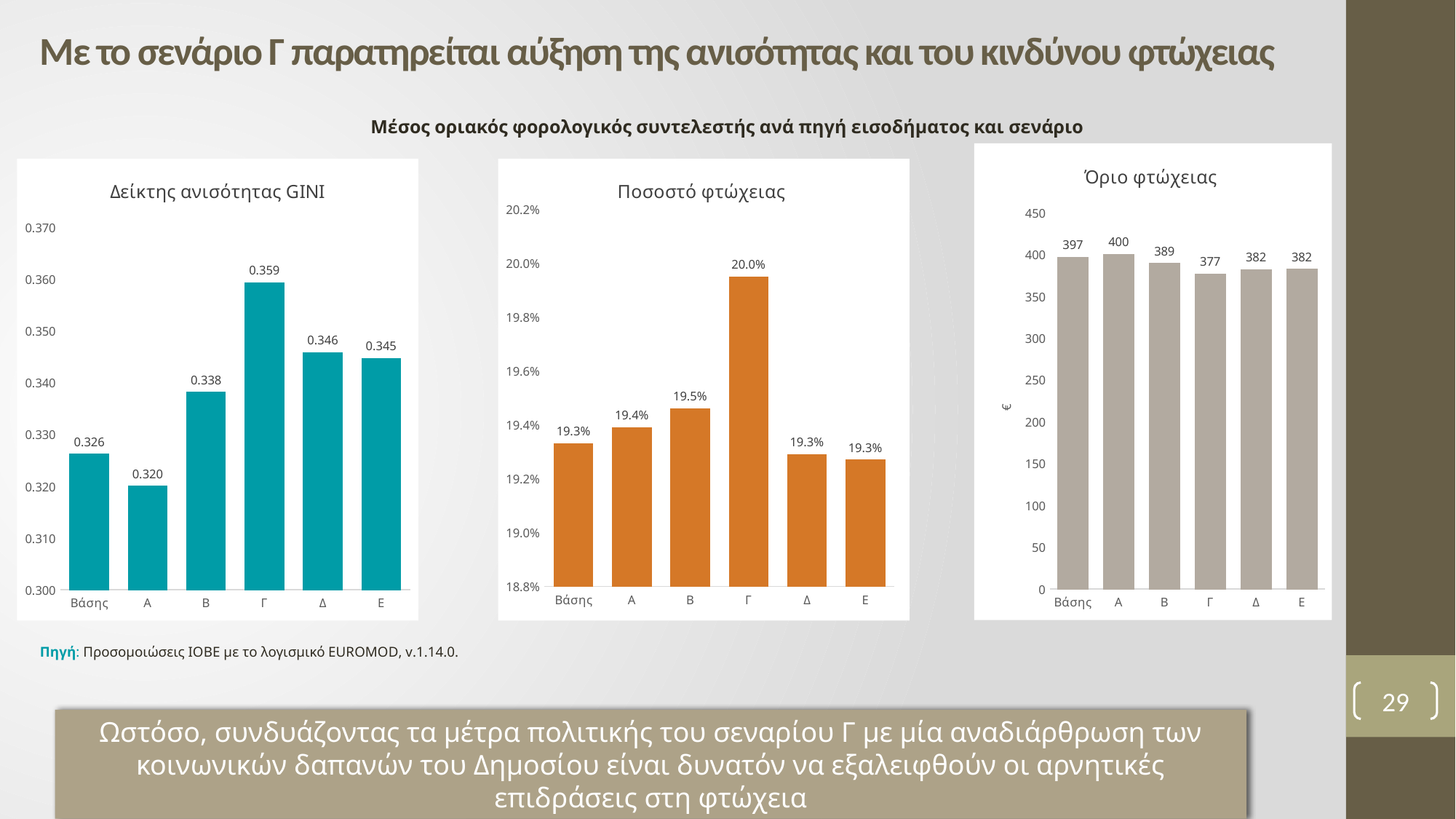
In the 'Δείκτης ανισότητας GINI' chart, what is the difference between the values for Γ and Βάσης? 0.033 In the 'Δείκτης ανισότητας GINI' chart, which is larger, the value for Δ or the value for Β? Δ In the 'Όριο φτώχειας' chart, what is the difference between the values for Βάσης and Γ? 20 In the 'Δείκτης ανισότητας GINI' chart, what is the value for scenario Γ? 0.359 In the 'Ποσοστό φτώχειας' chart, which category has the highest value? Γ In the 'Όριο φτώχειας' chart, what is the value for scenario Α? 400 In the 'Ποσοστό φτώχειας' chart, what is the value for scenario Β? 19.5% What is the title of the chart on the left of the slide? Δείκτης ανισότητας GINI What type of chart is the 'Όριο φτώχειας' chart? Bar chart In the 'Όριο φτώχειας' chart, which category has the lowest value? Γ In the 'Δείκτης ανισότητας GINI' chart, which category has the lowest value? Α In the 'Ποσοστό φτώχειας' chart, how many categories are shown on the x axis? 6